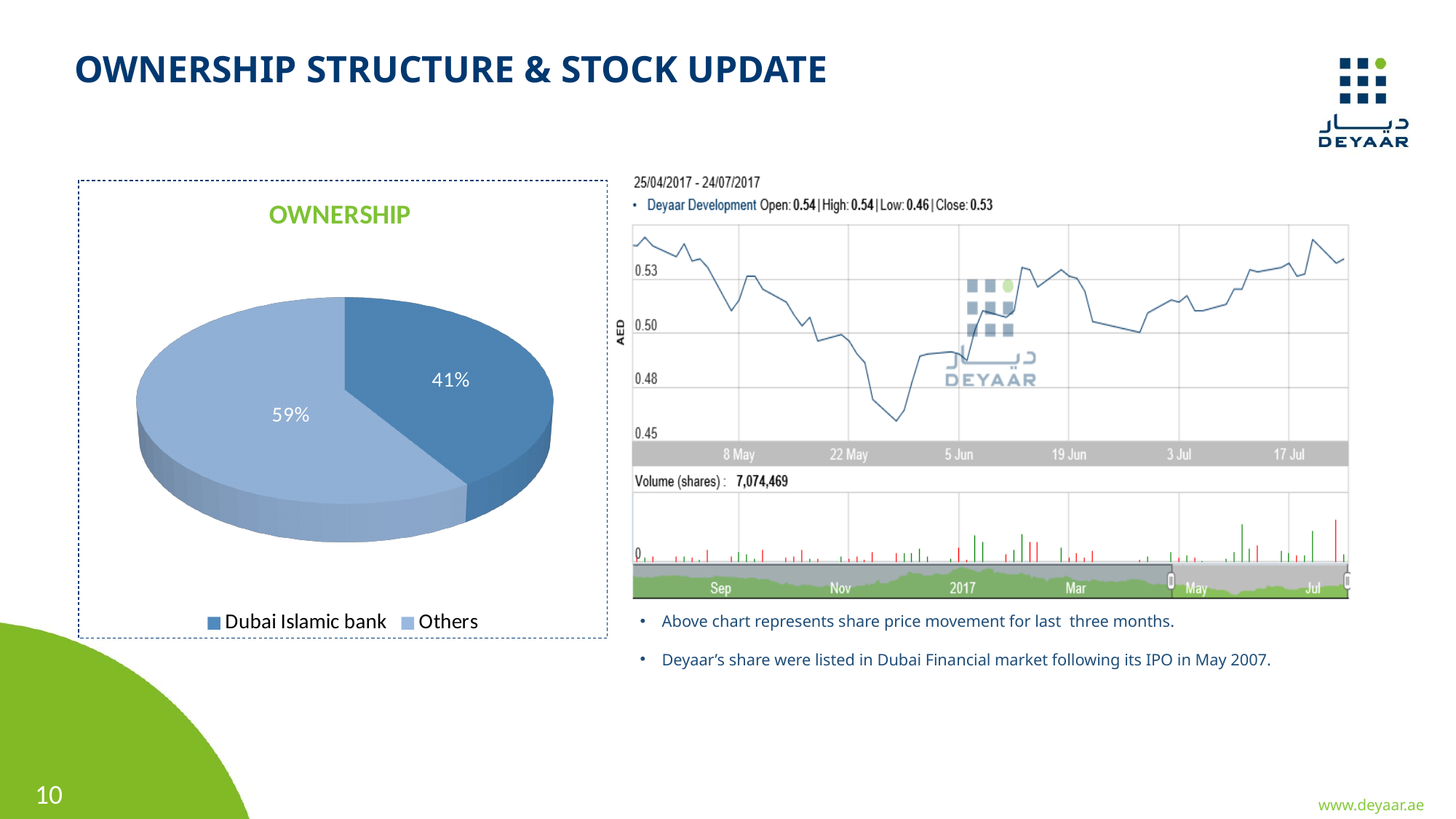
What kind of chart is the OWNERSHIP chart on the left of the slide? Pie chart In the OWNERSHIP pie chart, what is the difference in percentage points between the Others slice and the Dubai Islamic bank slice? 18 In the OWNERSHIP pie chart, what share is labelled Others? 59% In the Deyaar Development share price chart, what is the Low value shown in the header? 0.46 How many entries does the legend of the OWNERSHIP pie chart list? 2 In the Deyaar Development share price chart, what is the Close value shown in the header? 0.53 What kind of chart is the Deyaar Development share price chart on the right of the slide? Line chart In the OWNERSHIP pie chart, which is larger: Dubai Islamic bank or Others? Others In the OWNERSHIP pie chart, what share is held by Dubai Islamic bank? 41% In the OWNERSHIP pie chart, which slice is the largest? Others How many slices does the OWNERSHIP pie chart have? 2 In the OWNERSHIP pie chart, which slice is the smallest? Dubai Islamic bank